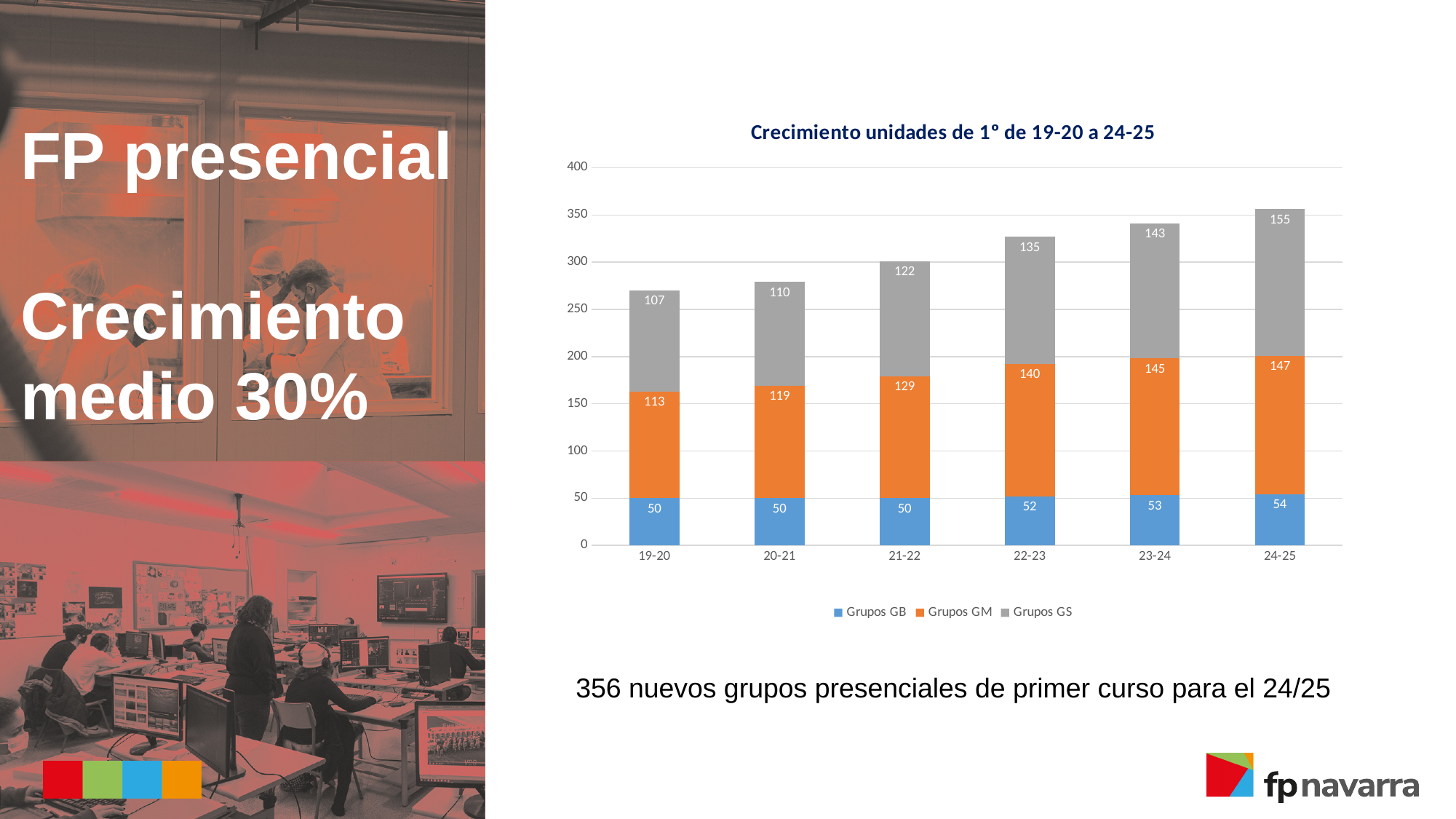
Which year has the lowest value for Grupos GM? 19-20 Which year has the highest value for Grupos GS? 24-25 What is the value of Grupos GB for 22-23? 52 How many series does the chart legend list? 3 Do the Grupos GS values rise or fall from 19-20 to 24-25? Rise What type of chart is shown on the slide? Stacked bar chart What is the total of the stacked bar for 24-25? 356 What is the value of Grupos GS for 24-25? 155 What is the title of the chart? Crecimiento unidades de 1° de 19-20 a 24-25 How many academic years (categories) are shown on the x axis? 6 What is the difference between the Grupos GM values for 24-25 and 19-20? 34 What is the value of Grupos GM for 21-22? 129